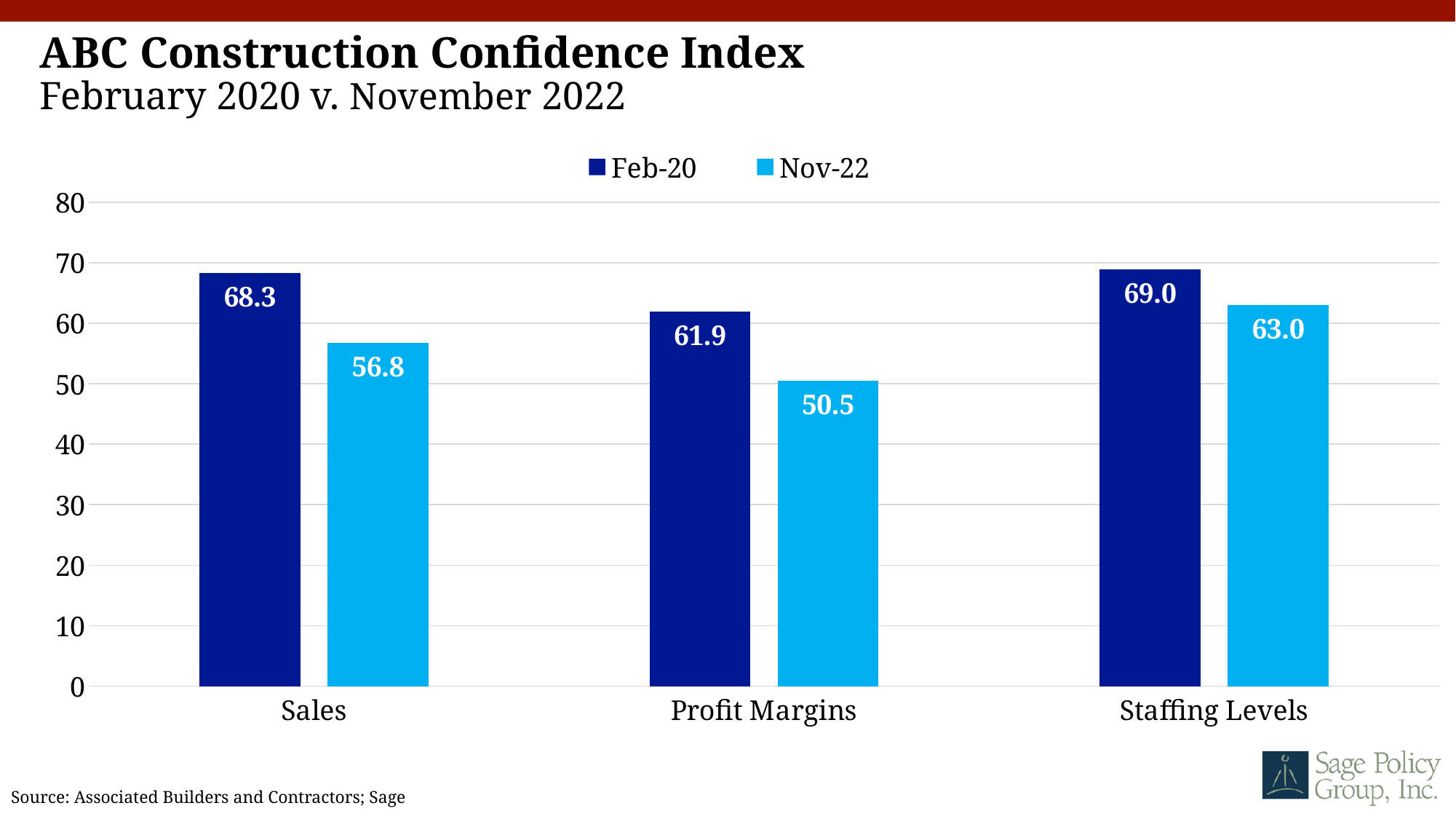
What is the Nov-22 value for Profit Margins? 50.5 What is the difference between the Feb-20 and Nov-22 values for Sales? 11.5 What is the difference between the Feb-20 and Nov-22 values for Profit Margins? 11.4 Which category has the highest Feb-20 value? Staffing Levels What is the Nov-22 value for Staffing Levels? 63.0 How many series does the legend list? 2 Which is larger, the Nov-22 value for Sales or the Nov-22 value for Staffing Levels? Staffing Levels What kind of chart is shown on the slide? Bar chart How many categories are shown on the x axis? 3 What is the title of the chart? ABC Construction Confidence Index What is the Feb-20 value for Sales? 68.3 Which category has the lowest Nov-22 value? Profit Margins